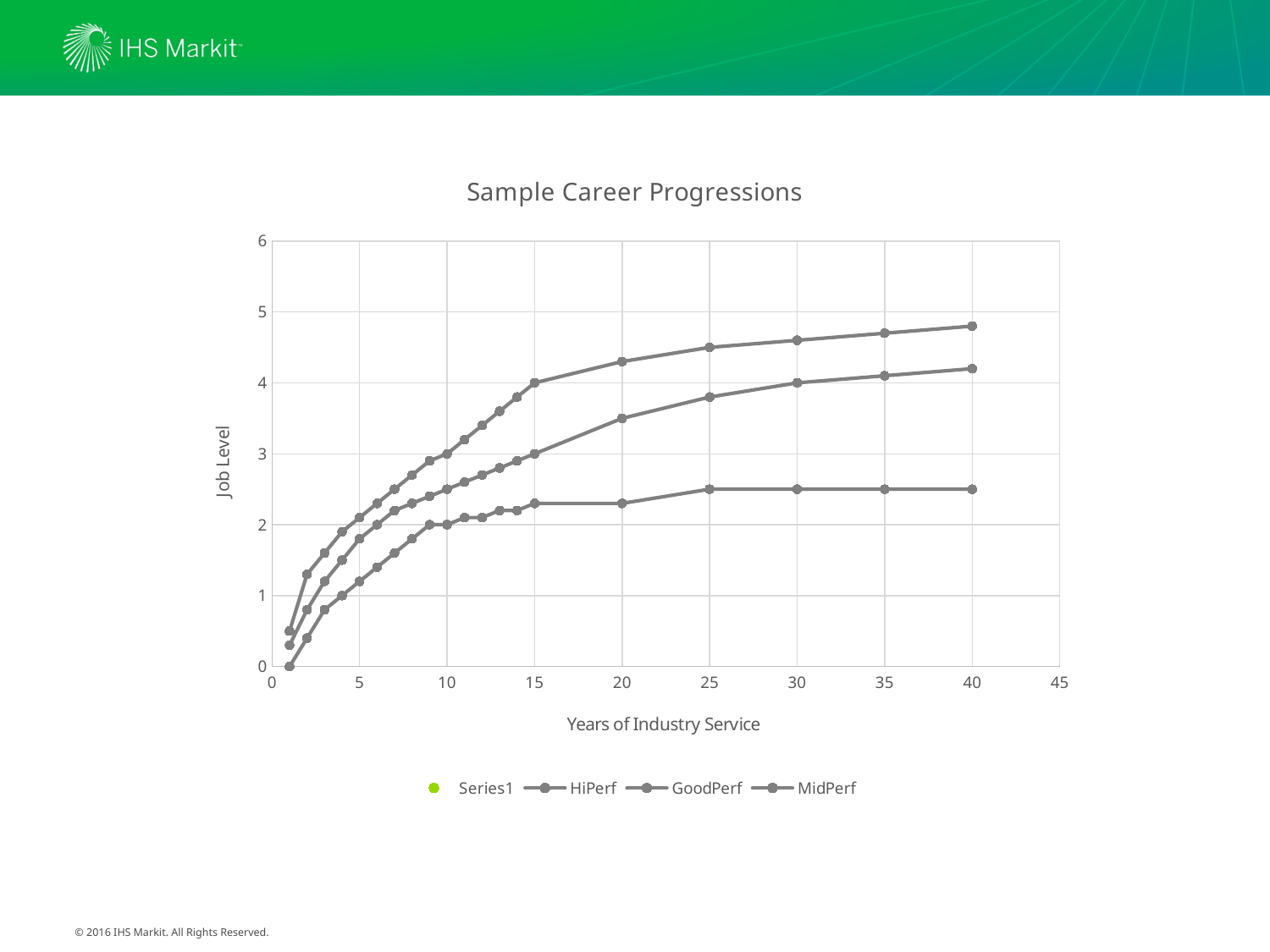
What is the title of the chart? Sample Career Progressions What Job Level does the middle line reach at 30 years of industry service? 4 Do the values of the top line rise or fall as years of industry service increase? rise Is the value of the bottom line at 40 years of industry service greater or less than 3? less Is the value of the middle line at 20 years of industry service greater or less than 3? greater Is the value of the top line at 40 years of industry service greater or less than 4? greater How many entries does the chart legend list? 4 What Job Level does the bottom line reach at 10 years of industry service? 2 What is the label on the x axis of the chart? Years of Industry Service How many lines are plotted on the chart? 3 What kind of chart is shown on the slide? line chart What Job Level does the top line reach at 15 years of industry service? 4